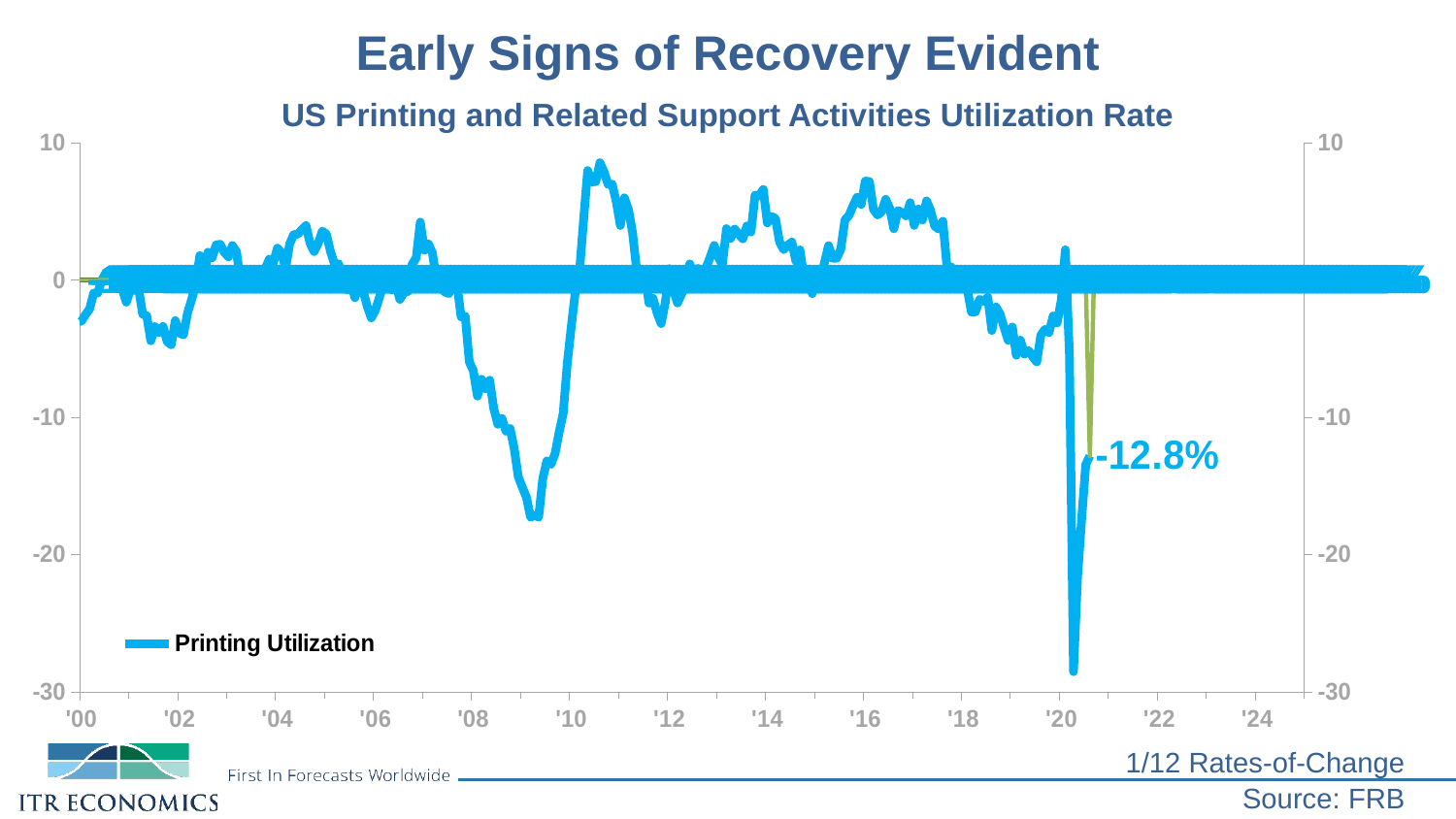
What is the title of the chart? US Printing and Related Support Activities Utilization Rate Which trough is lower, the one around 2009 or the one in 2020? 2020 What is the name of the series shown in the legend? Printing Utilization How many series does the legend list? 1 Between 2008 and early 2009, does the line rise or fall? fall Is the peak value the line reaches around 2010-2011 greater or less than 5? greater What is the value printed as a data label on the chart? -12.8% Is the lowest value the line reaches around 2009 greater or less than -10? less What kind of chart is shown on the slide? line chart Is the lowest value the line reaches in 2020 greater or less than -20? less In which year does the line reach its lowest point? 2020 After the 2020 trough, does the line rise or fall toward the -12.8% label? rise